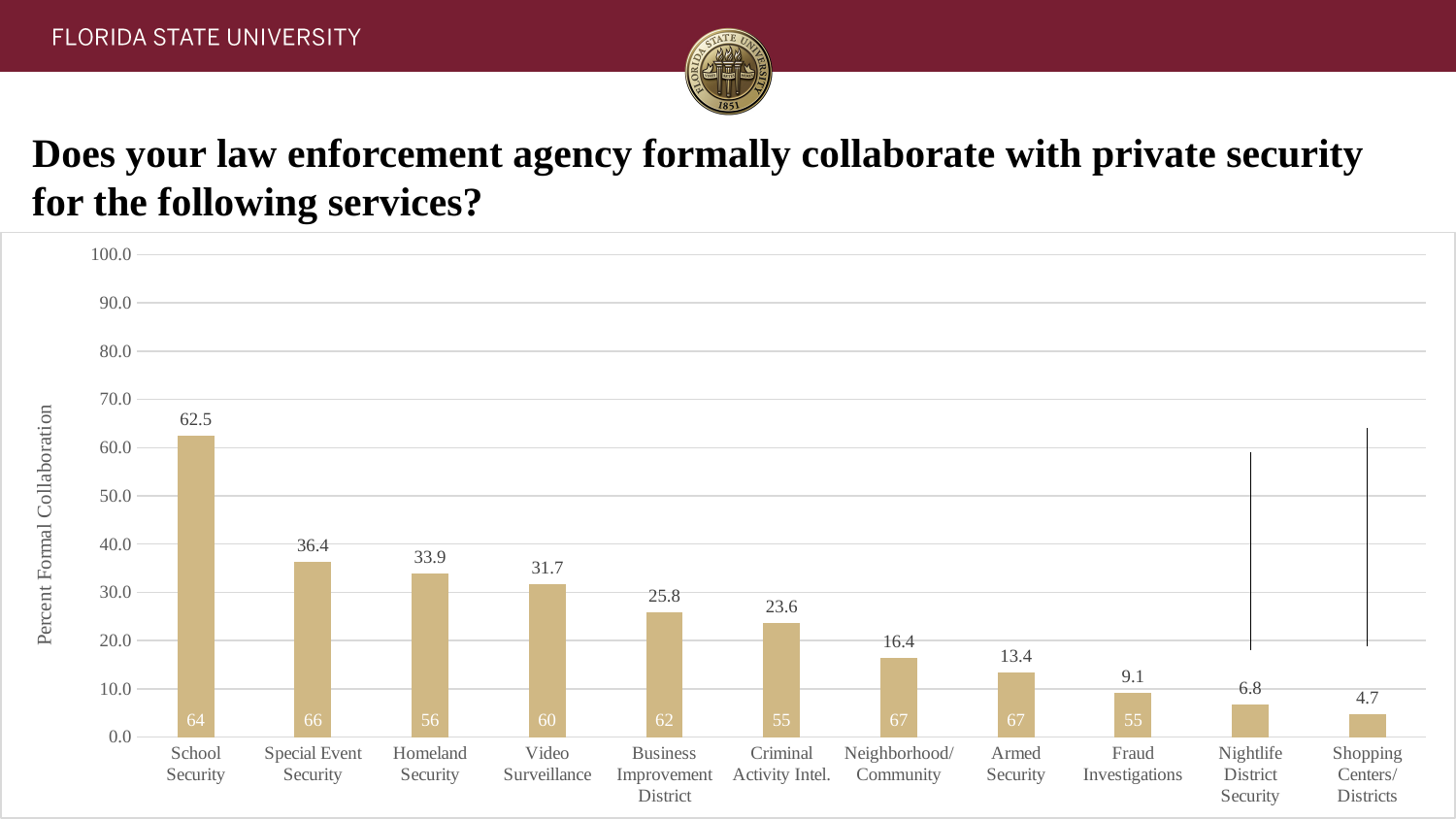
What kind of chart is shown on the slide? Bar chart Do the bar values rise or fall moving from left to right along the x axis? Fall What is the percent formal collaboration for School Security? 62.5 What is the label on the y axis of the chart? Percent Formal Collaboration Which has a higher percent formal collaboration, Homeland Security or Armed Security? Homeland Security What is the difference in percent formal collaboration between School Security and Special Event Security? 26.1 Which service has the highest percent formal collaboration? School Security How many services are shown on the x axis of the chart? 11 Which service has the lowest percent formal collaboration? Shopping Centers/Districts Is the value for Business Improvement District greater or less than 30.0? less What is the percent formal collaboration for Video Surveillance? 31.7 What is the percent formal collaboration for Fraud Investigations? 9.1